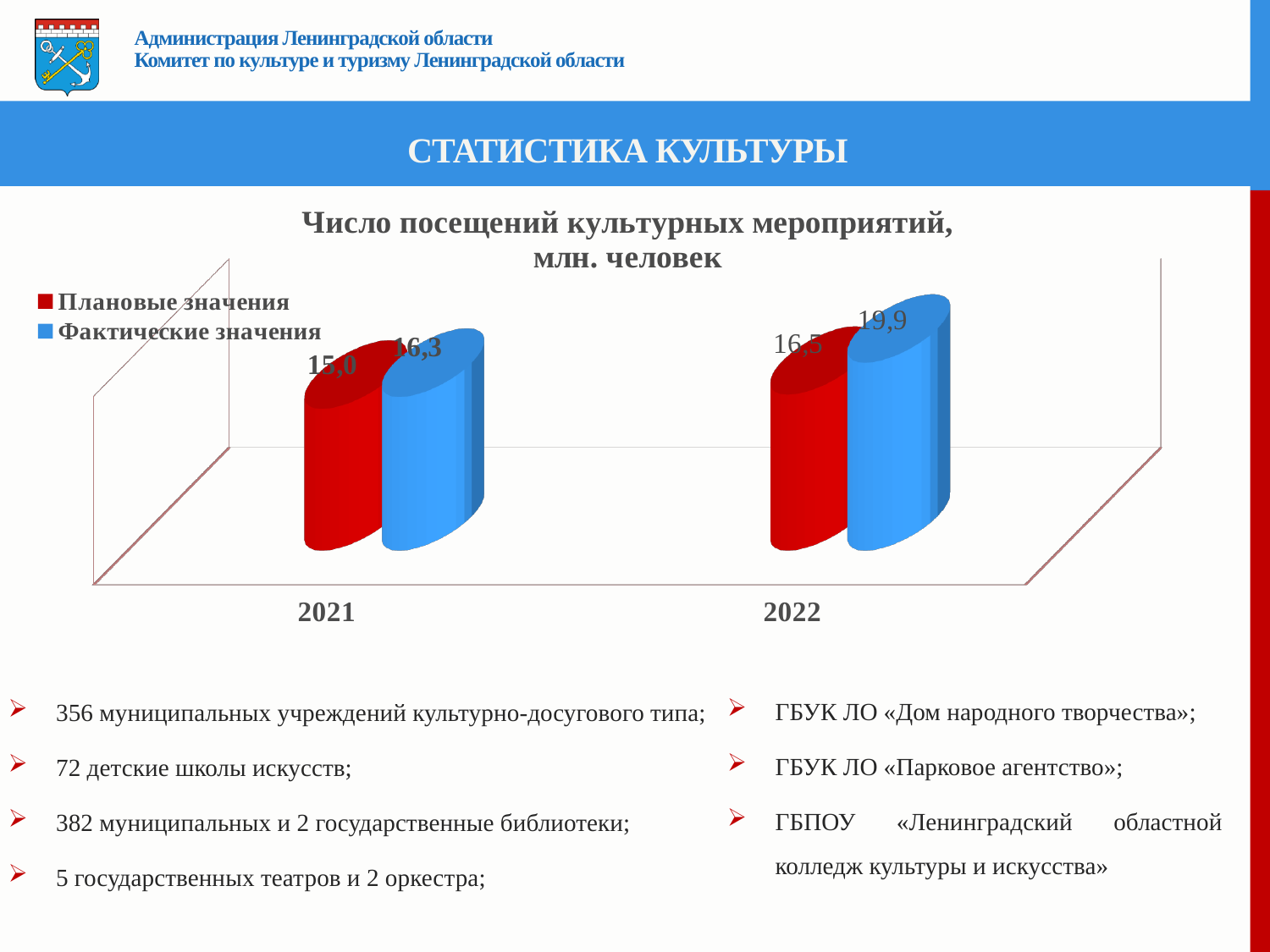
What is the actual value (Фактические значения) for 2021 in the chart? 16,3 How many years (categories) are shown on the x axis of the chart? 2 What is the planned value (Плановые значения) for 2022 in the chart? 16,5 Do the actual values (Фактические значения) rise or fall from 2021 to 2022? rise Which year has the lowest planned value (Плановые значения) in the chart? 2021 How many series does the chart legend list? 2 By how much does the actual value exceed the planned value in 2022? 3,4 Which is larger in 2021: the planned value or the actual value? Фактические значения (16,3) What is the difference between the actual value in 2022 and the actual value in 2021? 3,6 Which year has the highest actual value (Фактические значения) in the chart? 2022 What is the planned value (Плановые значения) for 2021 in the chart 'Число посещений культурных мероприятий, млн. человек'? 15,0 What is the actual value (Фактические значения) for 2022 in the chart? 19,9